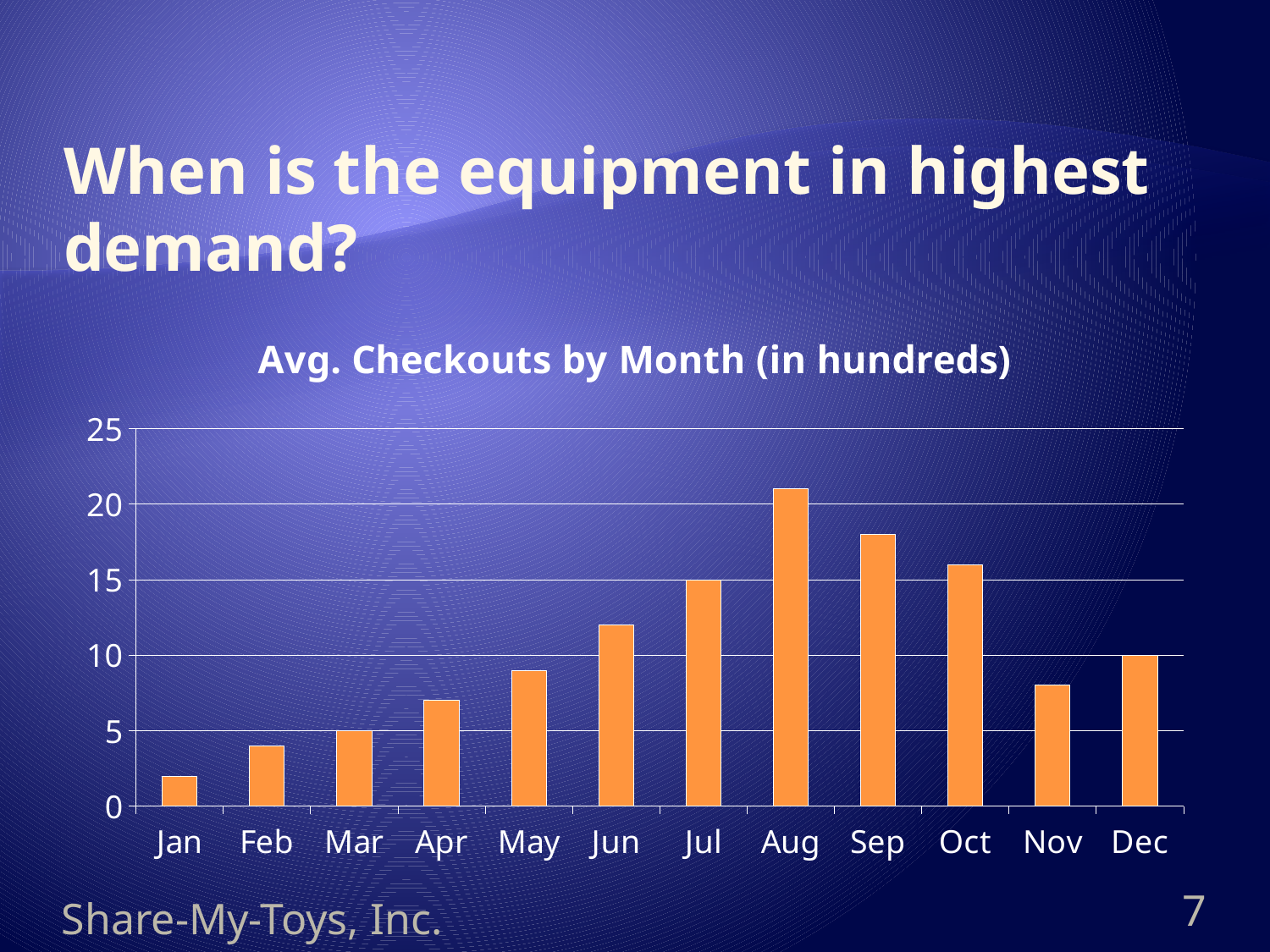
How do the values change from Jan to Aug? they rise Is the value for Aug greater or less than 20? greater Which month has the highest average checkouts? Aug What is the title of the chart? Avg. Checkouts by Month (in hundreds) Is the value for Nov greater or less than 10? less Which is larger, the value for Sep or the value for Oct? Sep What is the value for Dec? 10 What is the value for Mar? 5 What type of chart is shown on the slide? bar chart How many months are plotted on the x axis? 12 Which month has the lowest average checkouts? Jan What is the value for Jul? 15